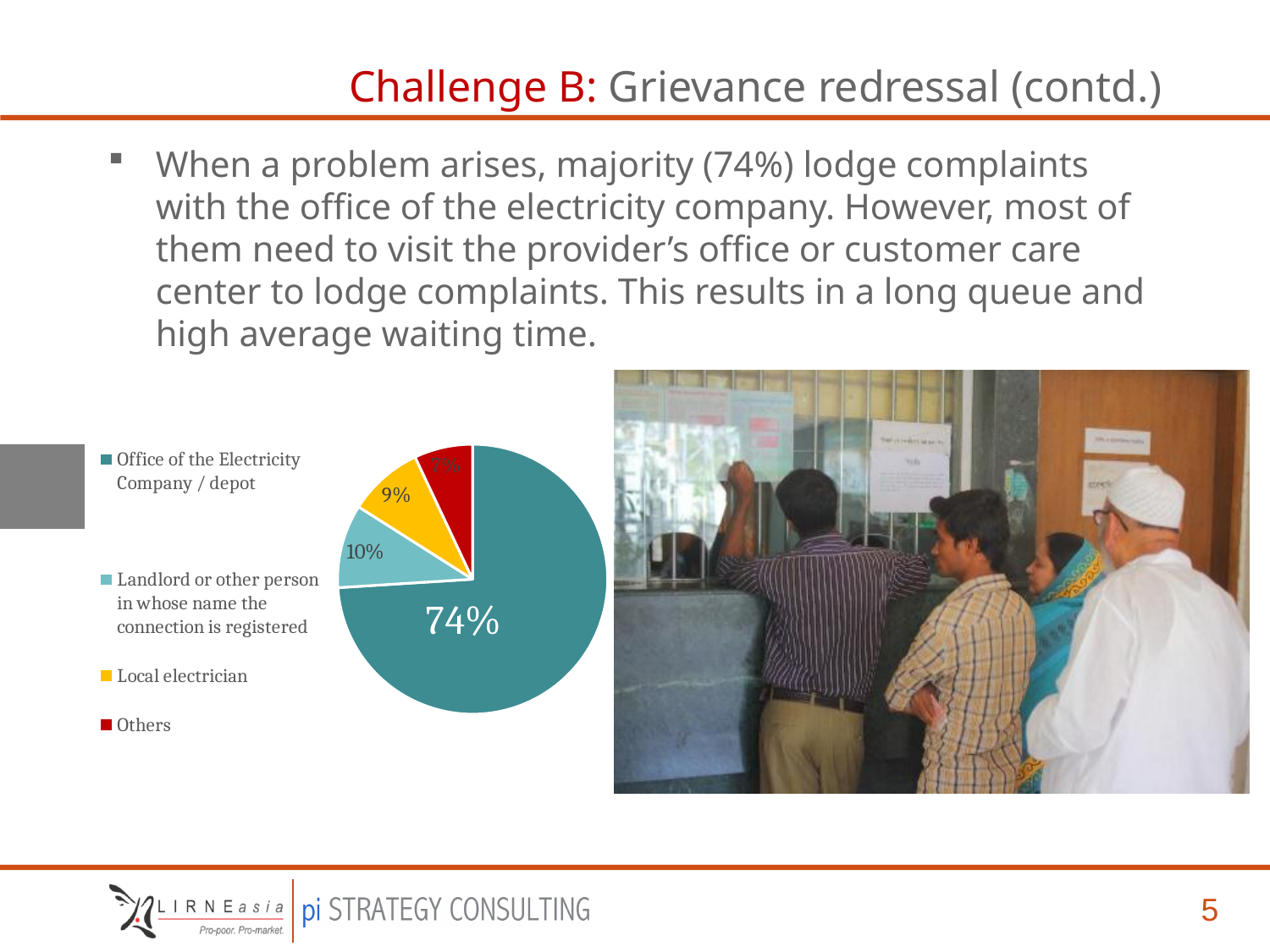
What percentage is shown for Landlord or other person in whose name the connection is registered? 10% How many slices does the pie chart have? 4 Which category has the largest slice of the pie? Office of the Electricity Company / depot Which category has the smallest slice of the pie? Others Which is larger: the slice for Local electrician or the slice for Landlord or other person in whose name the connection is registered? Landlord or other person in whose name the connection is registered What share of the pie is for Office of the Electricity Company / depot? 74% What percentage is shown for Others? 7% How many entries does the legend list? 4 What colour is the slice for Local electrician? yellow What kind of chart is shown on the slide? pie chart What is the difference in percentage points between Office of the Electricity Company / depot and Landlord or other person in whose name the connection is registered? 64 What percentage is shown for Local electrician? 9%